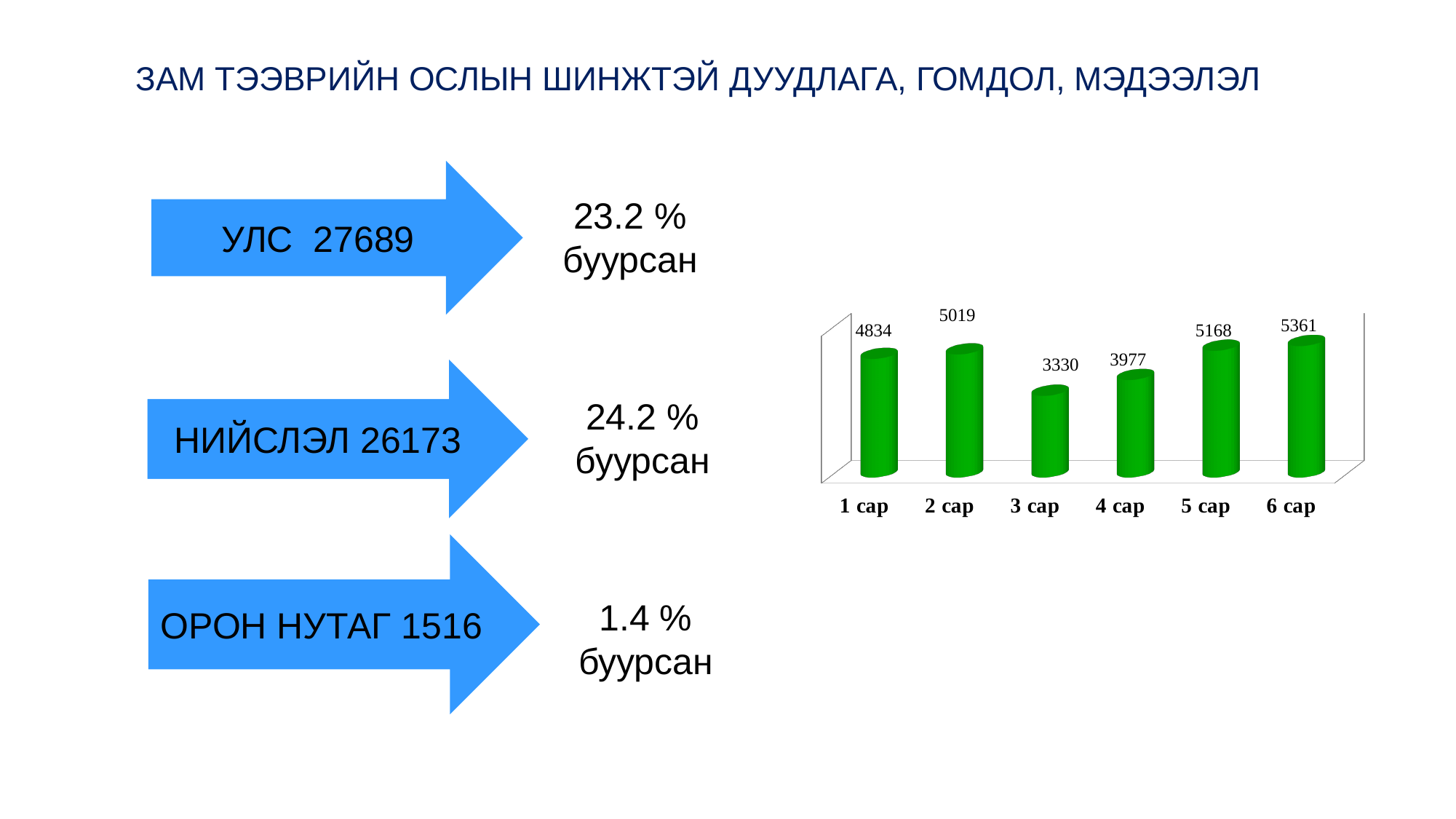
Which is larger, the value for 4 сар or the value for 5 сар? 5 сар What kind of chart is shown on the slide? bar chart What is the value for 1 сар? 4834 What is the value for 3 сар? 3330 What is the difference between the values for 2 сар and 1 сар? 185 What colour are the bars in the chart? green Do the values rise or fall from 3 сар to 6 сар? rise How many months are shown on the chart? 6 Which month has the highest value? 6 сар What is the value for 6 сар? 5361 What is the difference between the values for 6 сар and 3 сар? 2031 Which month has the lowest value? 3 сар